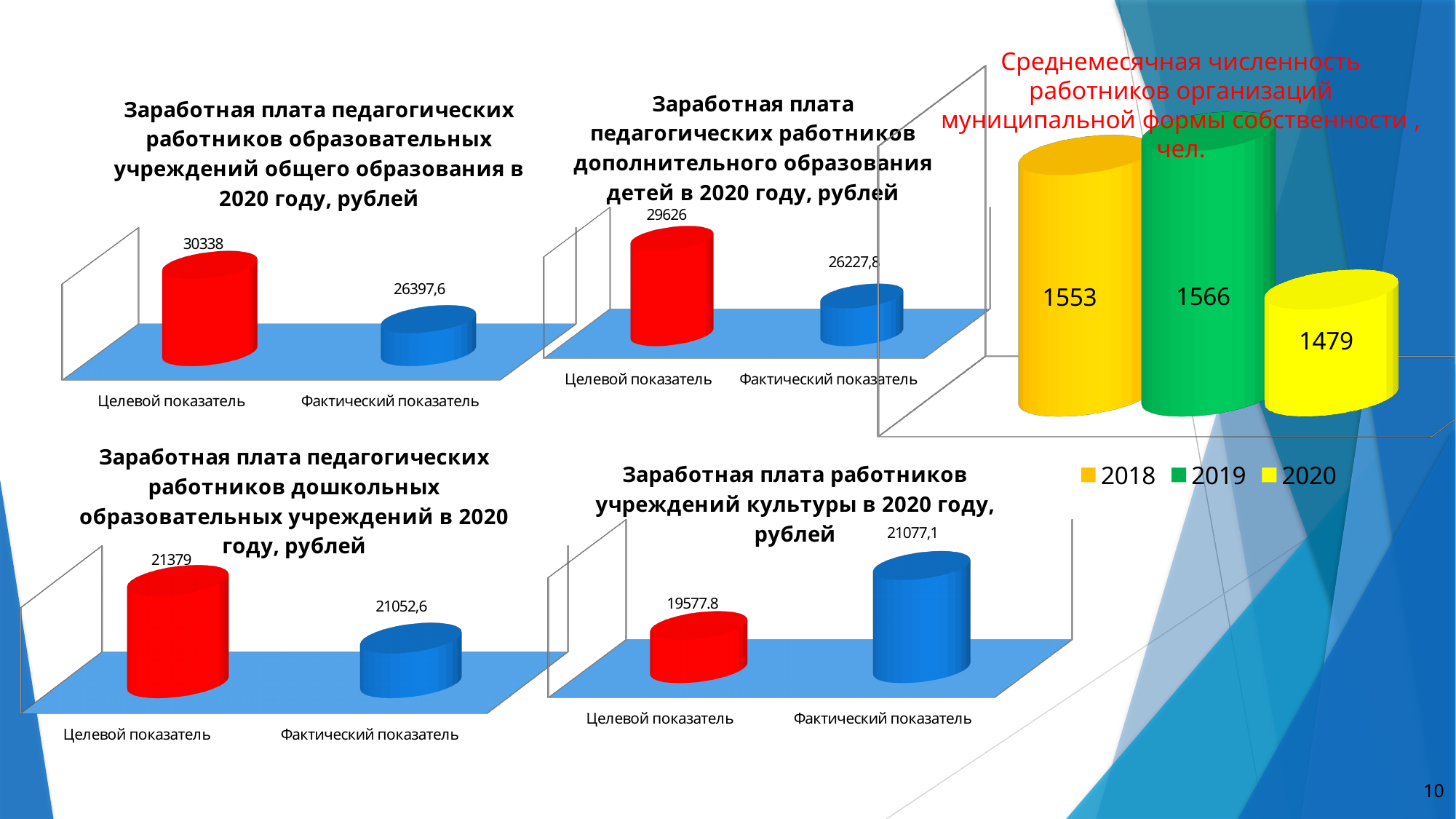
In the chart 'Заработная плата педагогических работников дошкольных образовательных учреждений в 2020 году, рублей', what is the value for 'Фактический показатель'? 21052,6 In the chart 'Заработная плата педагогических работников образовательных учреждений общего образования в 2020 году, рублей', what is the value for 'Целевой показатель'? 30338 In the chart 'Заработная плата педагогических работников дополнительного образования детей в 2020 году, рублей', which is larger, 'Целевой показатель' or 'Фактический показатель'? Целевой показатель In the chart 'Заработная плата работников учреждений культуры в 2020 году, рублей', what is the value for 'Целевой показатель'? 19577.8 In the chart 'Среднемесячная численность работников организаций муниципальной формы собственности, чел.', which year has the lowest value? 2020 In the chart 'Среднемесячная численность работников организаций муниципальной формы собственности, чел.', what is the value for 2019? 1566 In the chart 'Заработная плата педагогических работников дополнительного образования детей в 2020 году, рублей', what is the value for 'Целевой показатель'? 29626 How many series does the legend of the chart 'Среднемесячная численность работников организаций муниципальной формы собственности, чел.' list? 3 In the chart 'Среднемесячная численность работников организаций муниципальной формы собственности, чел.', what is the difference between the 2019 and 2020 values? 87 What kind of chart is 'Заработная плата педагогических работников дошкольных образовательных учреждений в 2020 году, рублей'? Bar chart In the chart 'Заработная плата педагогических работников образовательных учреждений общего образования в 2020 году, рублей', what is the value for 'Фактический показатель'? 26397,6 In the chart 'Заработная плата работников учреждений культуры в 2020 году, рублей', which category has the highest value? Фактический показатель